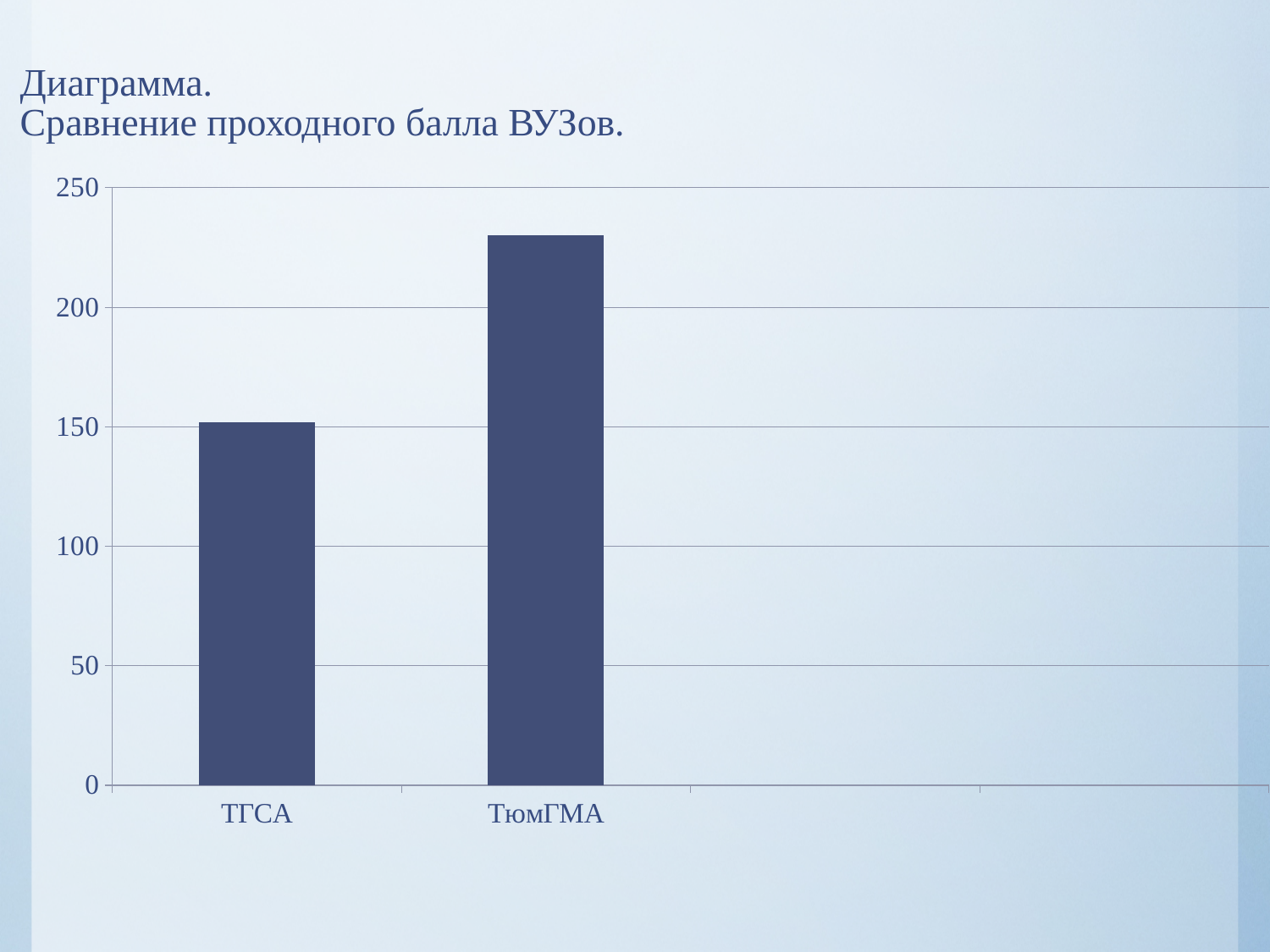
Which category has the lowest value? ТГСА What is the highest value shown on the vertical axis? 250 Is the value for ТюмГМА greater or less than 250? less How many categories are plotted on the chart? 2 What is the title of the slide above the chart? Диаграмма. Сравнение проходного балла ВУЗов. Which is larger, the value for ТГСА or the value for ТюмГМА? ТюмГМА Which category has the highest value? ТюмГМА Is the value for ТГСА greater or less than 100? greater What kind of chart is shown on the slide? bar chart Is the value for ТюмГМА greater or less than 200? greater